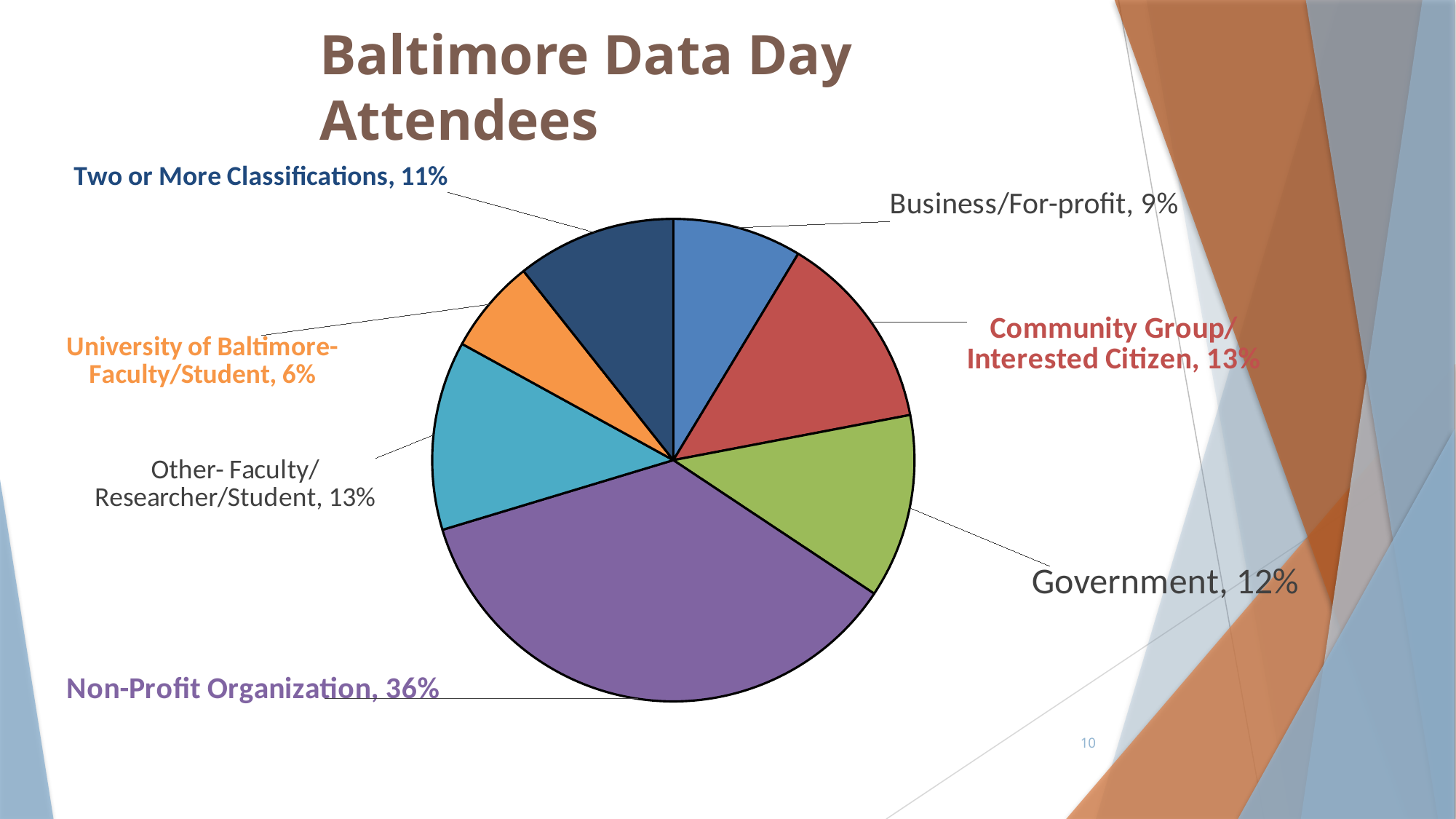
What share of Baltimore Data Day attendees were from a Non-Profit Organization? 36% What percentage of attendees were Business/For-profit? 9% How many categories are shown in the pie chart? 7 Which is larger: the share for Two or More Classifications or the share for Business/For-profit? Two or More Classifications What percentage of attendees were University of Baltimore Faculty/Student? 6% What is the difference in percentage points between Non-Profit Organization and Community Group/Interested Citizen? 23 What kind of chart is shown on the slide? pie chart Which category has the largest share of attendees? Non-Profit Organization What percentage of attendees were classified as Government? 12% What is the combined share of Government and Business/For-profit attendees? 21% Which category has the smallest share of attendees? University of Baltimore-Faculty/Student What is the title of the chart on the slide? Baltimore Data Day Attendees